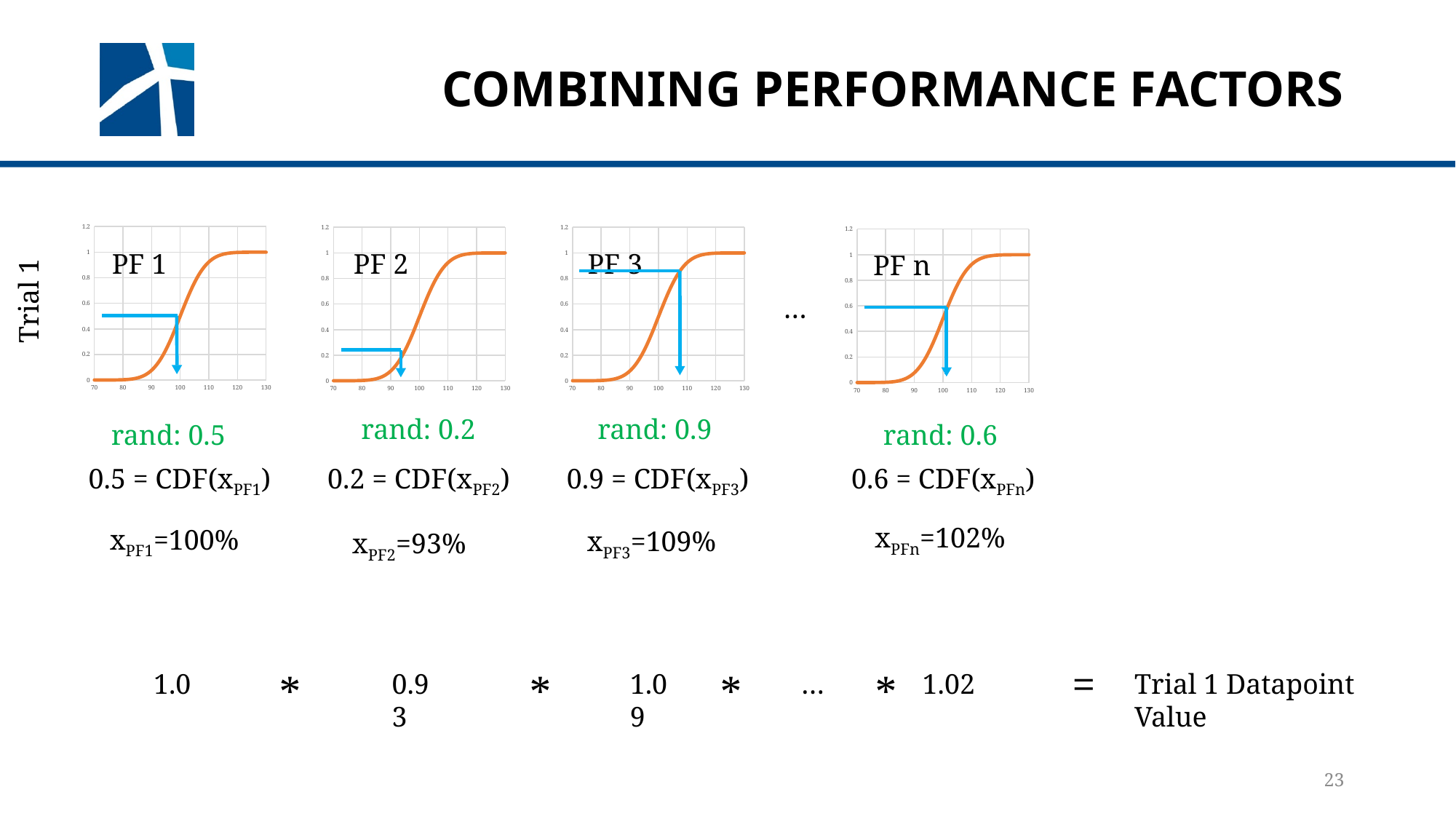
In the PF 1 chart, does the curve rise or fall as the x axis increases? rise Which chart's x value is the lowest among PF 1, PF 2, PF 3 and PF n? PF 2 What is the rand value shown under the PF 2 chart? 0.2 In the PF 1 chart, is the curve's value at x = 110 greater or less than 0.6? greater What is the x value (x_PFn) shown under the PF n chart? 102% Which chart's x value is the highest among PF 1, PF 2, PF 3 and PF n? PF 3 What kind of chart is the PF 1 chart? line chart By how many percentage points does x_PF3 exceed x_PF2? 16 How many charts are shown on the slide? 4 What is the x value (x_PF3) shown under the PF 3 chart? 109% What is the highest tick label on the y axis of the PF 2 chart? 1.2 Which is larger, the rand value for PF 1 or the rand value for PF n? PF n